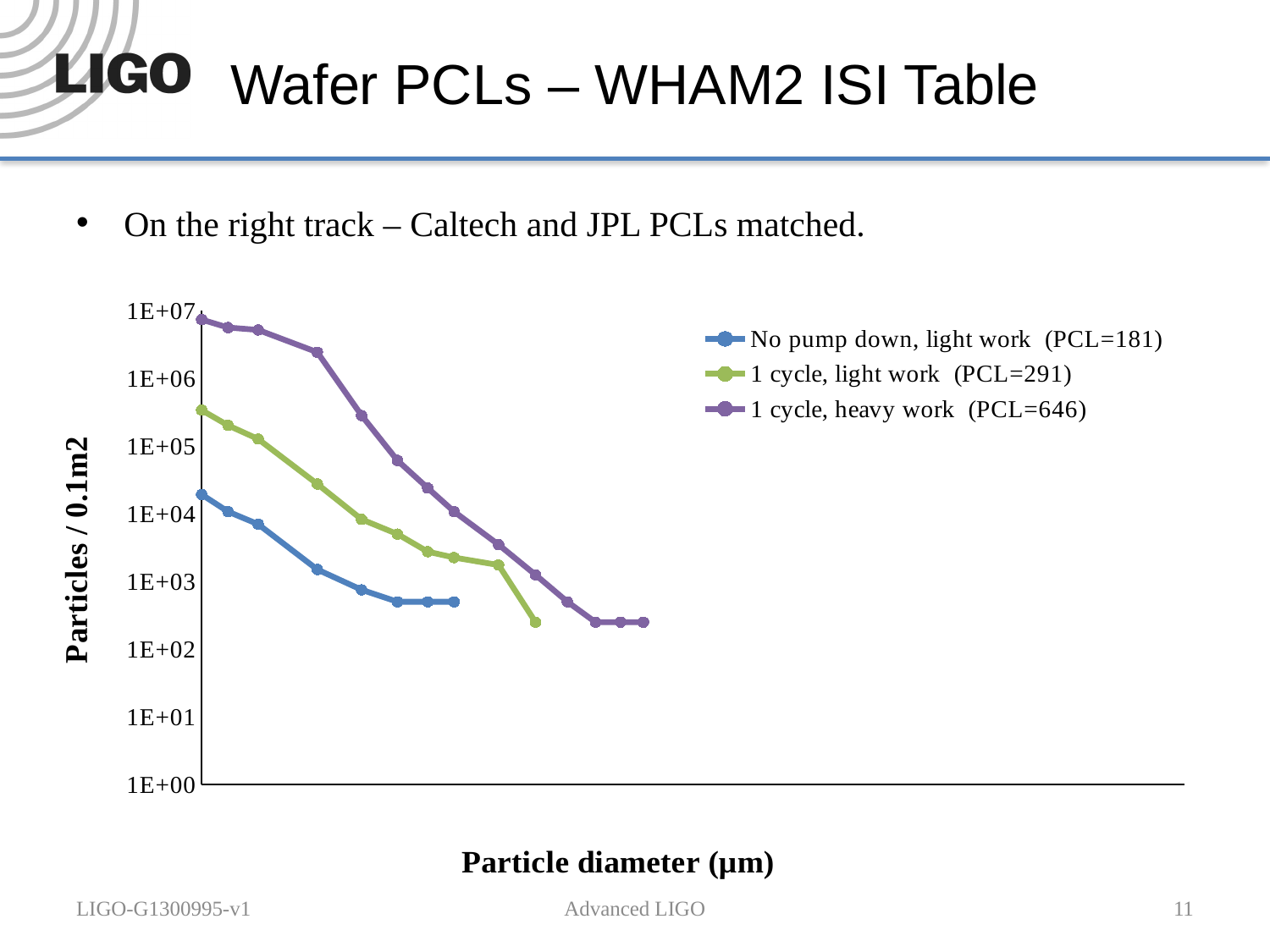
At the smallest particle diameter, which is larger: the value for '1 cycle, light work' or for 'No pump down, light work'? 1 cycle, light work What PCL value does the legend give for the '1 cycle, heavy work' series? 646 Which series has the highest particle count at the smallest particle diameter? 1 cycle, heavy work (PCL=646) Is the first value of the '1 cycle, heavy work' series greater or less than 1E+06? greater Is the first value of the '1 cycle, light work' series greater or less than 1E+05? greater What kind of chart is shown on the slide? line chart What is the title of the y axis? Particles / 0.1m2 Is the last value of the 'No pump down, light work' series greater or less than 1E+03? less Which series has the lowest particle count at the smallest particle diameter? No pump down, light work (PCL=181) How many series does the legend list? 3 Do the particle counts rise or fall as particle diameter increases along the x axis? fall